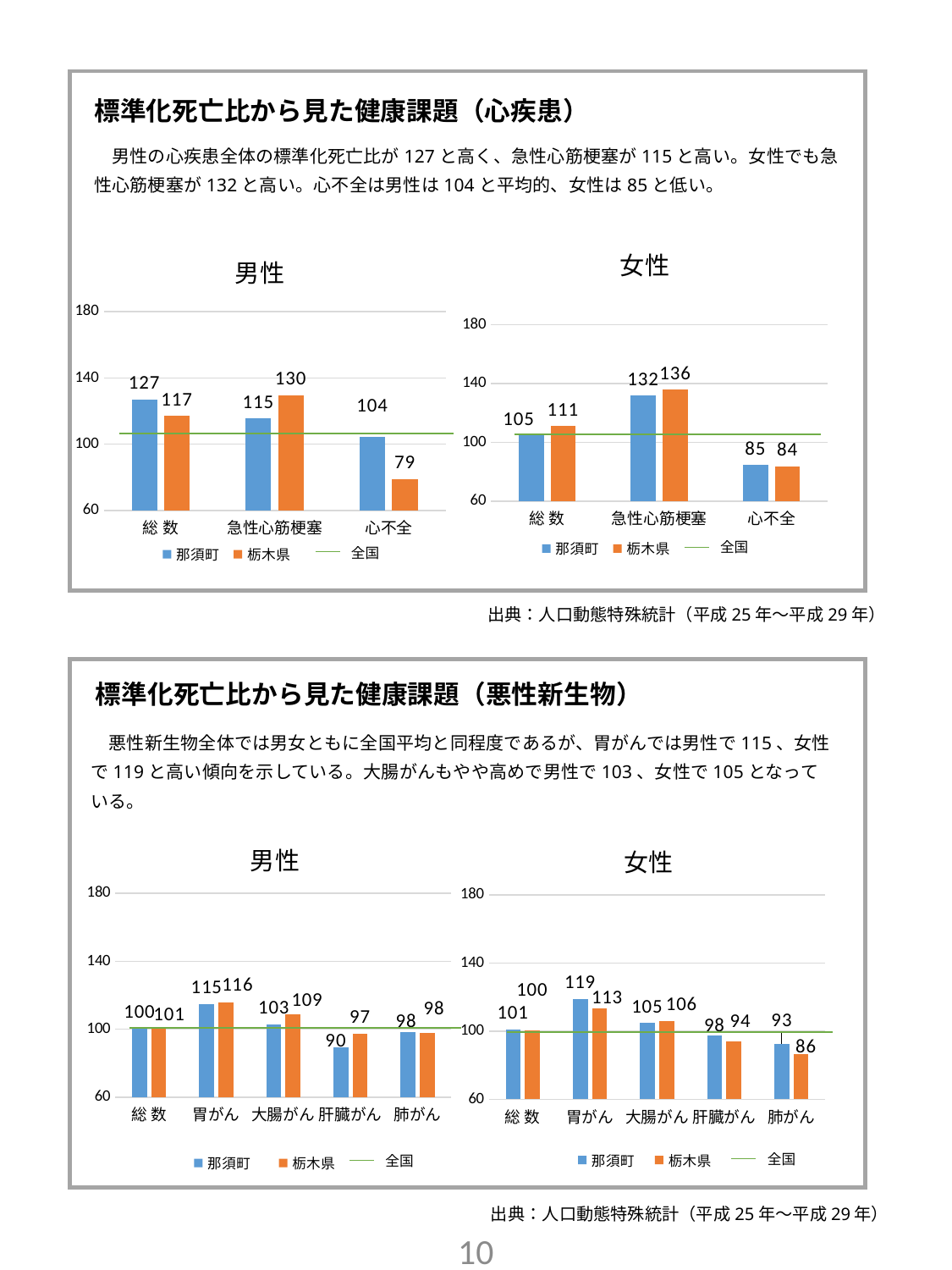
How many entries does the legend of the 心疾患 女性 chart list? 3 In the 心疾患 男性 chart, which is larger for 総数: 那須町 or 栃木県? 那須町 How many categories are shown on the x axis of the 悪性新生物 男性 chart? 5 In the 心疾患 女性 chart, which category has the highest 那須町 value? 急性心筋梗塞 In the 悪性新生物 女性 chart, what is the value for 那須町 for 胃がん? 119 In the 心疾患 男性 chart, what is the value for 栃木県 for 心不全? 79 In the 心疾患 男性 chart, what is the difference between the 栃木県 and 那須町 values for 急性心筋梗塞? 15 In the 悪性新生物 男性 chart, what is the value for 那須町 for 肝臓がん? 90 In the 悪性新生物 女性 chart, which category has the lowest 栃木県 value? 肺がん In the 心疾患 女性 chart, what is the value for 栃木県 for 急性心筋梗塞? 136 What kind of chart is the 悪性新生物 女性 chart? Bar chart In the 心疾患 男性 chart, what is the value for 那須町 for 総数? 127